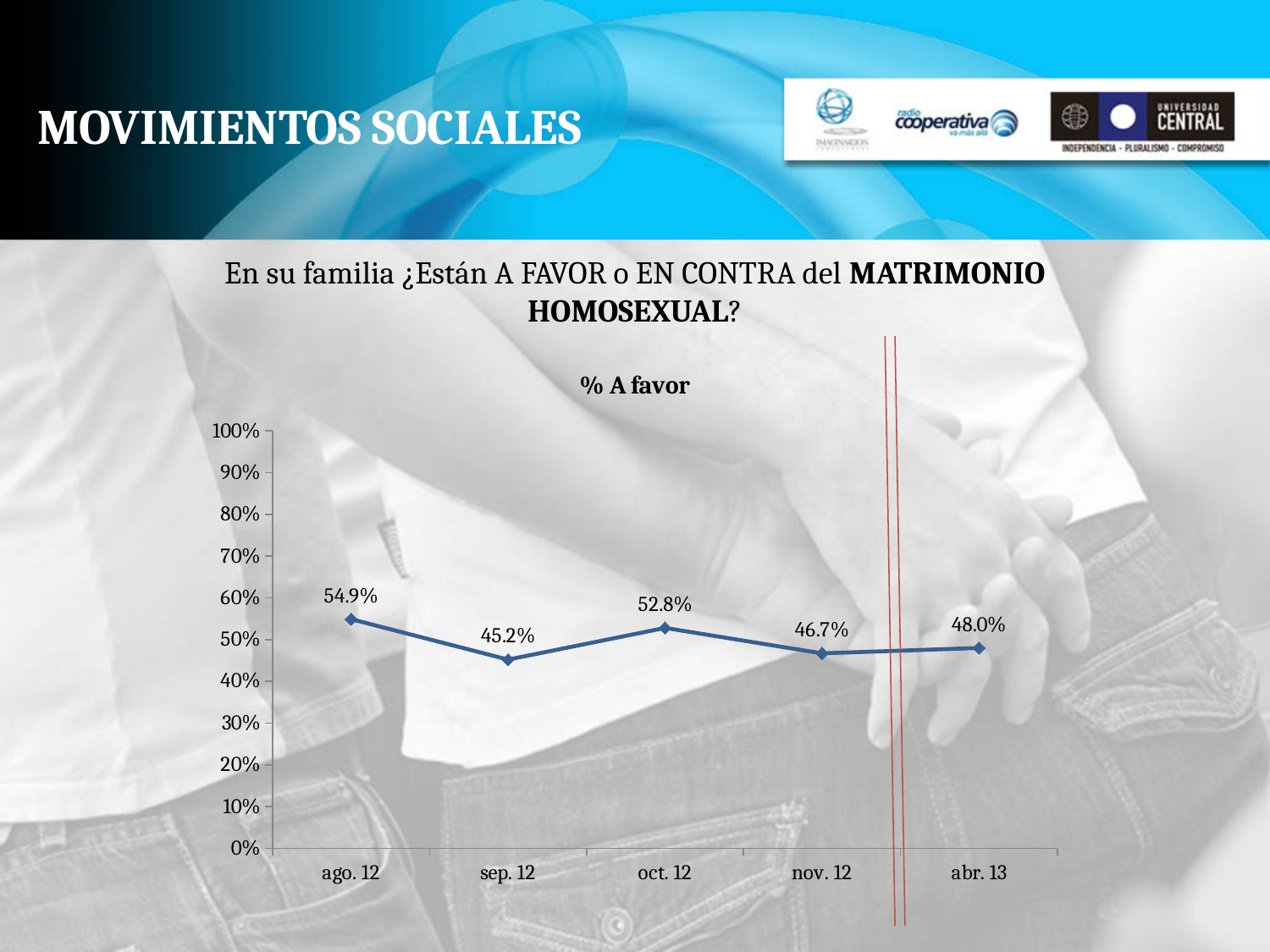
Does the value rise or fall from ago. 12 to sep. 12? fall Which is larger, the value for oct. 12 or the value for nov. 12? oct. 12 What is the value for abr. 13? 48.0% What is the value for ago. 12? 54.9% What is the difference between the values for ago. 12 and sep. 12? 9.7% Which month has the highest value? ago. 12 Is the value for nov. 12 greater or less than 50%? less How many data points are plotted on the chart? 5 What is the title of the chart? % A favor What kind of chart is shown? line chart What is the value for sep. 12? 45.2% Which month has the lowest value? sep. 12